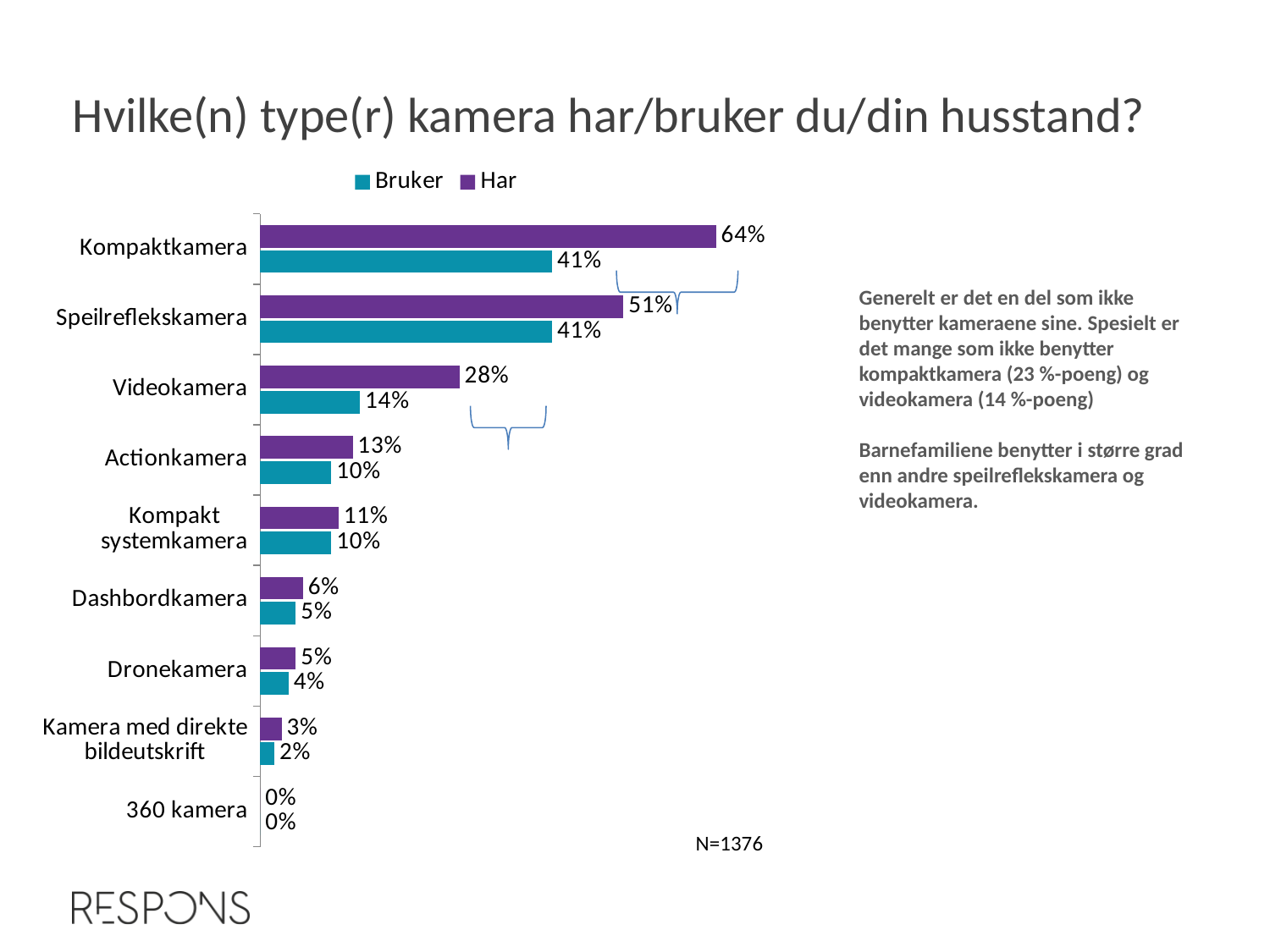
What are the two series named in the legend? Bruker and Har Which category has the lowest 'Bruker' value? 360 kamera Which category has the highest 'Har' value? Kompaktkamera What is the 'Har' value for Speilreflekskamera? 51% What is the 'Har' value for Kompaktkamera? 64% How many series does the legend list? 2 What is the 'Bruker' value for Dashbordkamera? 5% What kind of chart is shown on the slide? Bar chart What is the 'Bruker' value for Videokamera? 14% Which is larger for Videokamera: the 'Har' value or the 'Bruker' value? Har How many categories are shown on the chart? 9 What is the difference between the 'Har' and 'Bruker' values for Kompaktkamera? 23%